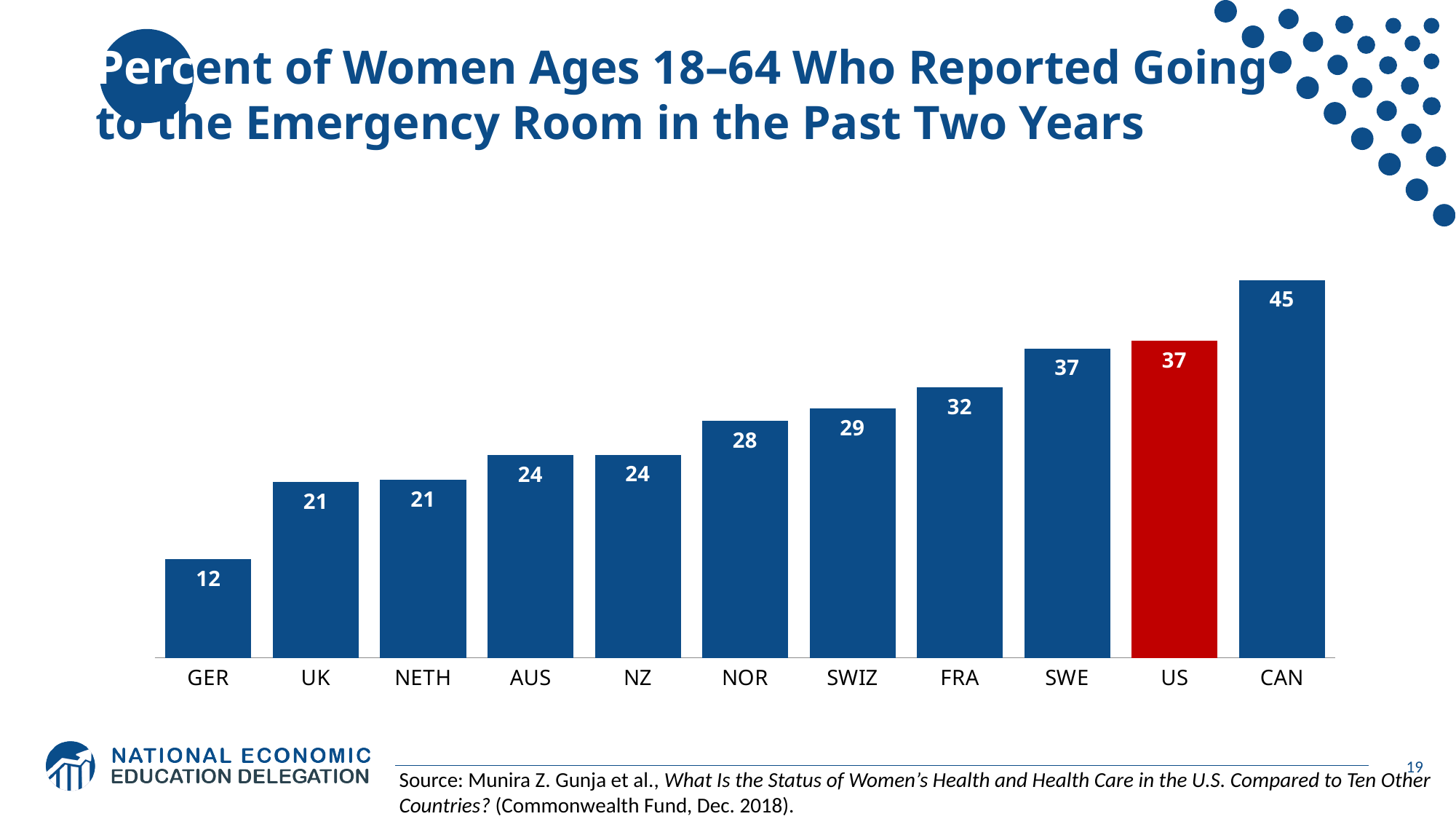
What is the value for the US? 37 Which bar is coloured red rather than blue? US How many countries are shown on the chart? 11 What is the difference between the values for FRA and GER? 20 Which country has the highest value? CAN Do the values rise or fall from left to right along the x axis? rise Which is larger, the value for SWIZ or the value for NZ? SWIZ Which country has the lowest value? GER What is the difference between the values for CAN and the US? 8 What is the value for GER? 12 What is the value for NOR? 28 What kind of chart is shown on the slide? bar chart